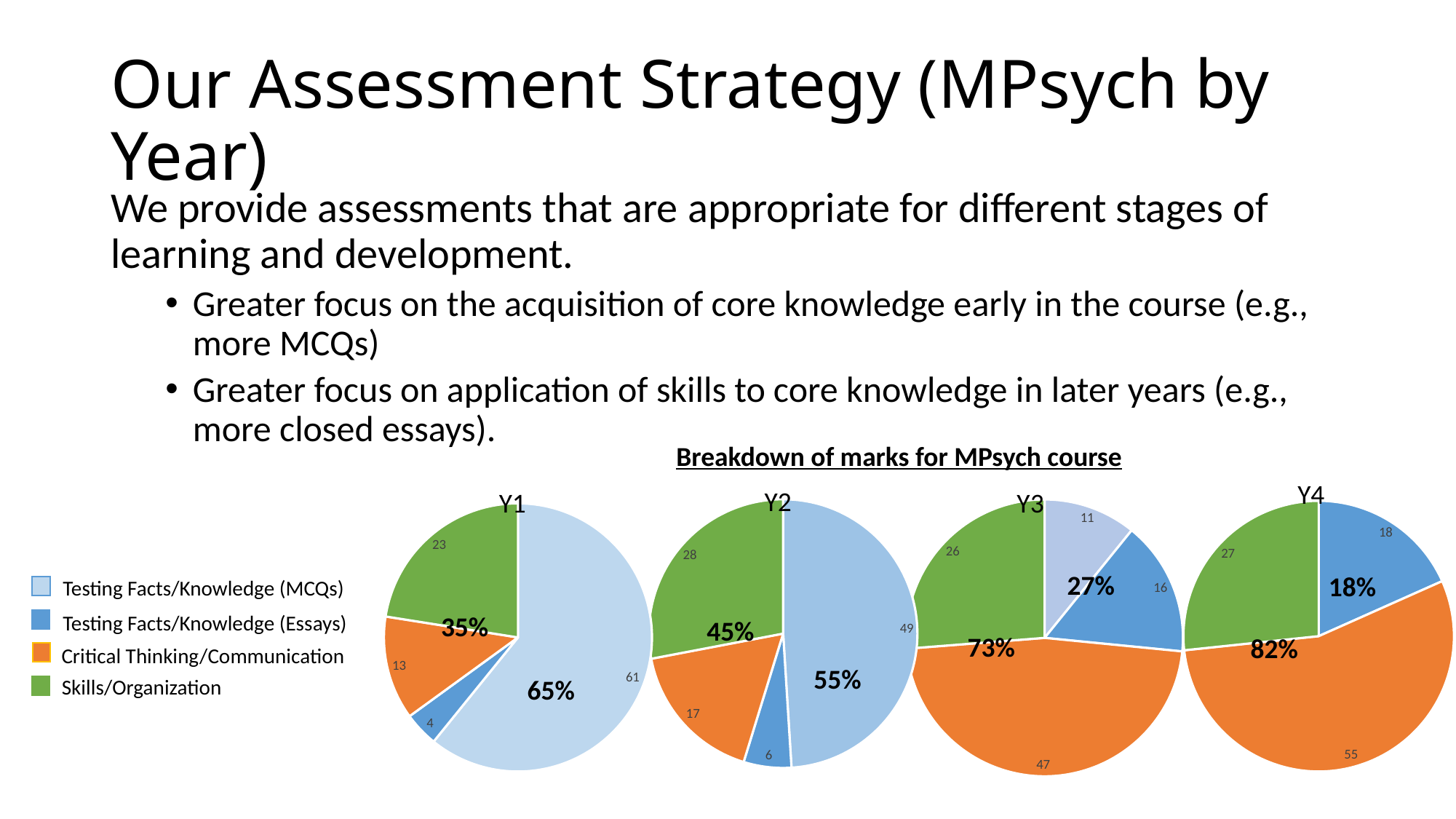
In the Y4 pie chart, which category has the largest slice? Critical Thinking/Communication How many categories does the legend list? 4 In the Y2 pie chart, which is larger: Skills/Organization or Critical Thinking/Communication? Skills/Organization In the Y1 pie chart, what is the value for Skills/Organization? 23 In the Y1 pie chart, which category has the smallest slice? Testing Facts/Knowledge (Essays) What type of charts are shown on the slide? Pie charts In the Y3 pie chart, what is the value for Testing Facts/Knowledge (Essays)? 16 In the Y3 pie chart, what is the difference between the Critical Thinking/Communication value and the Skills/Organization value? 21 How many pie charts are shown on the slide? 4 What is the title shown above the pie charts? Breakdown of marks for MPsych course In the Y1 pie chart, what is the value for Testing Facts/Knowledge (MCQs)? 61 In the Y2 pie chart, what is the value for Critical Thinking/Communication? 17